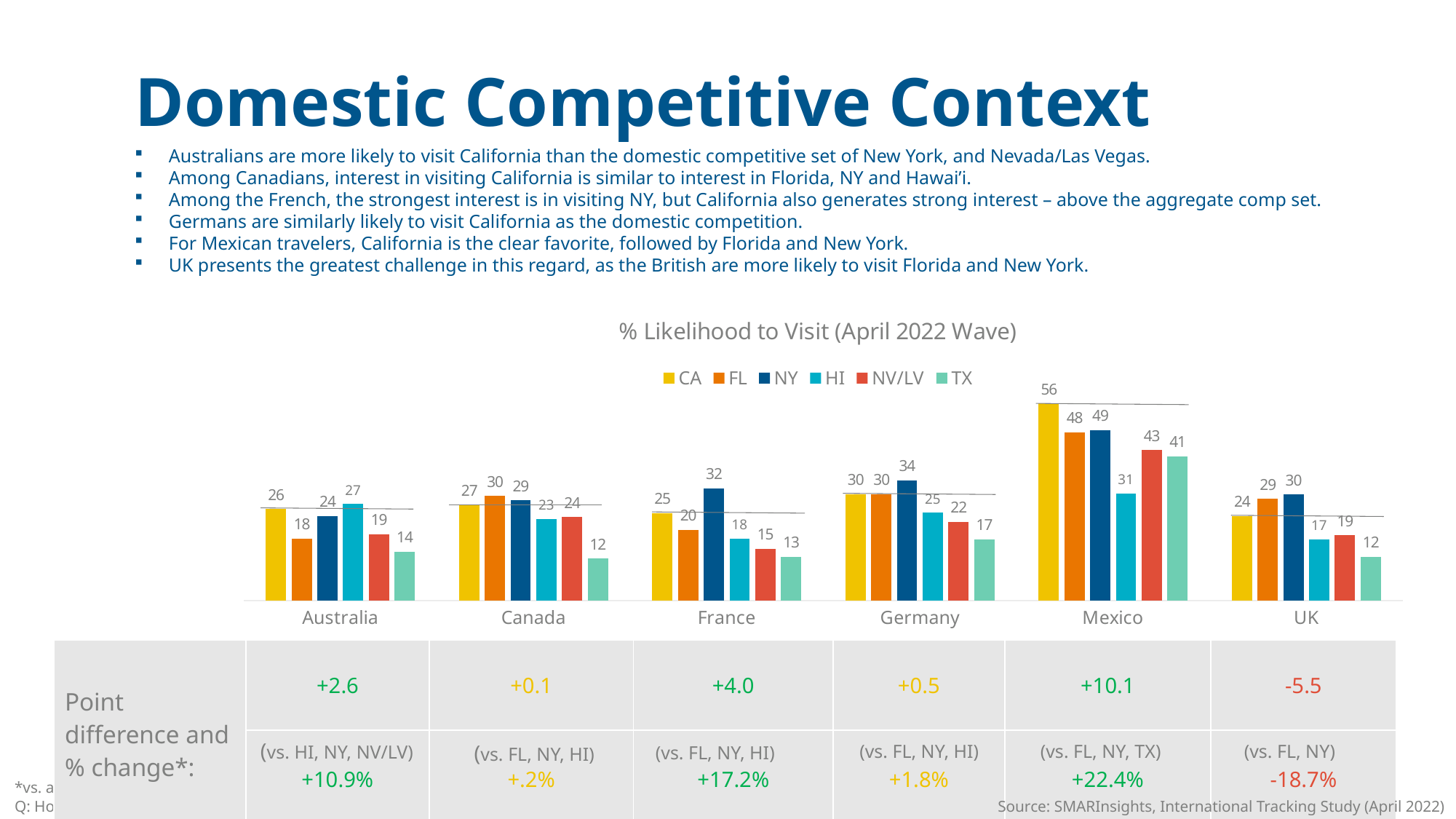
What kind of chart is shown on the slide? Bar chart How many series does the legend list? 6 How many countries are shown on the x axis? 6 What is the HI value for Australia? 27 Which country has the highest CA value? Mexico For the UK, which is larger, the CA value or the FL value? FL What is the title of the chart? % Likelihood to Visit (April 2022 Wave) What is the CA value for Mexico? 56 What is the difference between the CA and FL values for Mexico? 8 What is the NY value for France? 32 Which series has the lowest value for the UK? TX What is the TX value for Canada? 12